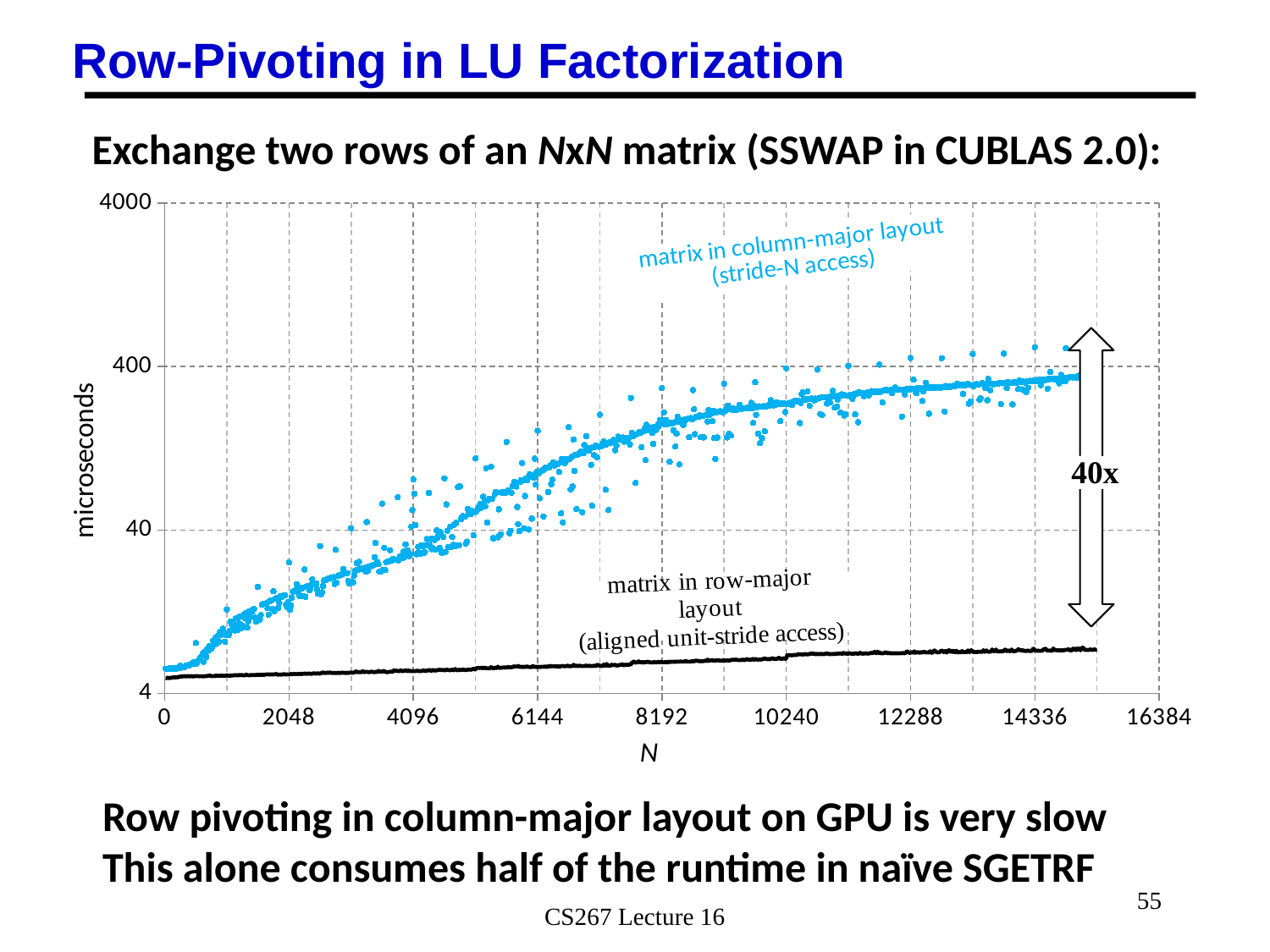
Does the column-major layout series rise or fall as N increases? rise What is the label of the y axis? microseconds What kind of chart is shown on the slide? scatter chart Is the value for the column-major layout series at N = 2048 greater or less than 40 microseconds? less How many data series are plotted on the chart? 2 What is the label of the x axis? N Is the value for the column-major layout series at N = 14336 greater or less than 40 microseconds? greater Which series has the lower values across the whole range of N? row-major layout At N = 8192, which series has the larger value: column-major layout or row-major layout? column-major layout Is the value for the row-major layout series at N = 8192 greater or less than 40 microseconds? less What is the highest tick value shown on the y axis? 4000